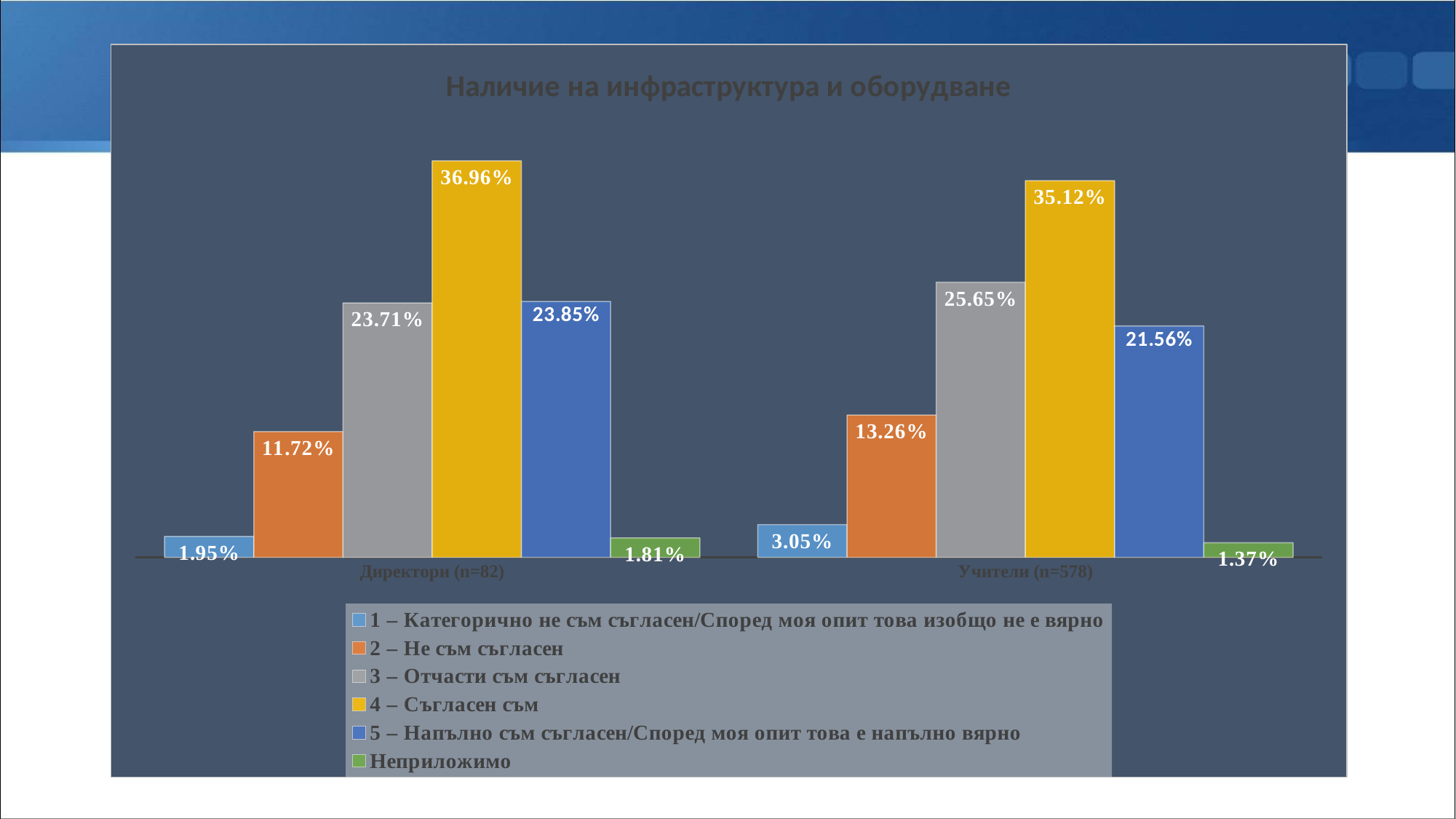
What is the value for "2 – Не съм съгласен" in the Учители (n=578) category? 13.26% How many series does the legend list? 6 What is the value for "Неприложимо" in the Учители (n=578) category? 1.37% What is the title of the chart? Наличие на инфраструктура и оборудване Which series has the lowest value in the Директори (n=82) category? Неприложимо What is the difference between the "4 – Съгласен съм" values for Директори (n=82) and Учители (n=578)? 1.84% Which series has the highest value in the Учители (n=578) category? 4 – Съгласен съм What type of chart is shown on the slide? bar chart What is the value for "4 – Съгласен съм" in the Директори (n=82) category? 36.96% Which is larger: the "3 – Отчасти съм съгласен" value for Директори (n=82) or for Учители (n=578)? Учители (n=578) What is the difference between the "5 – Напълно съм съгласен/Според моя опит това е напълно вярно" value and the "2 – Не съм съгласен" value in the Директори (n=82) category? 12.13% How many categories are shown on the x axis? 2